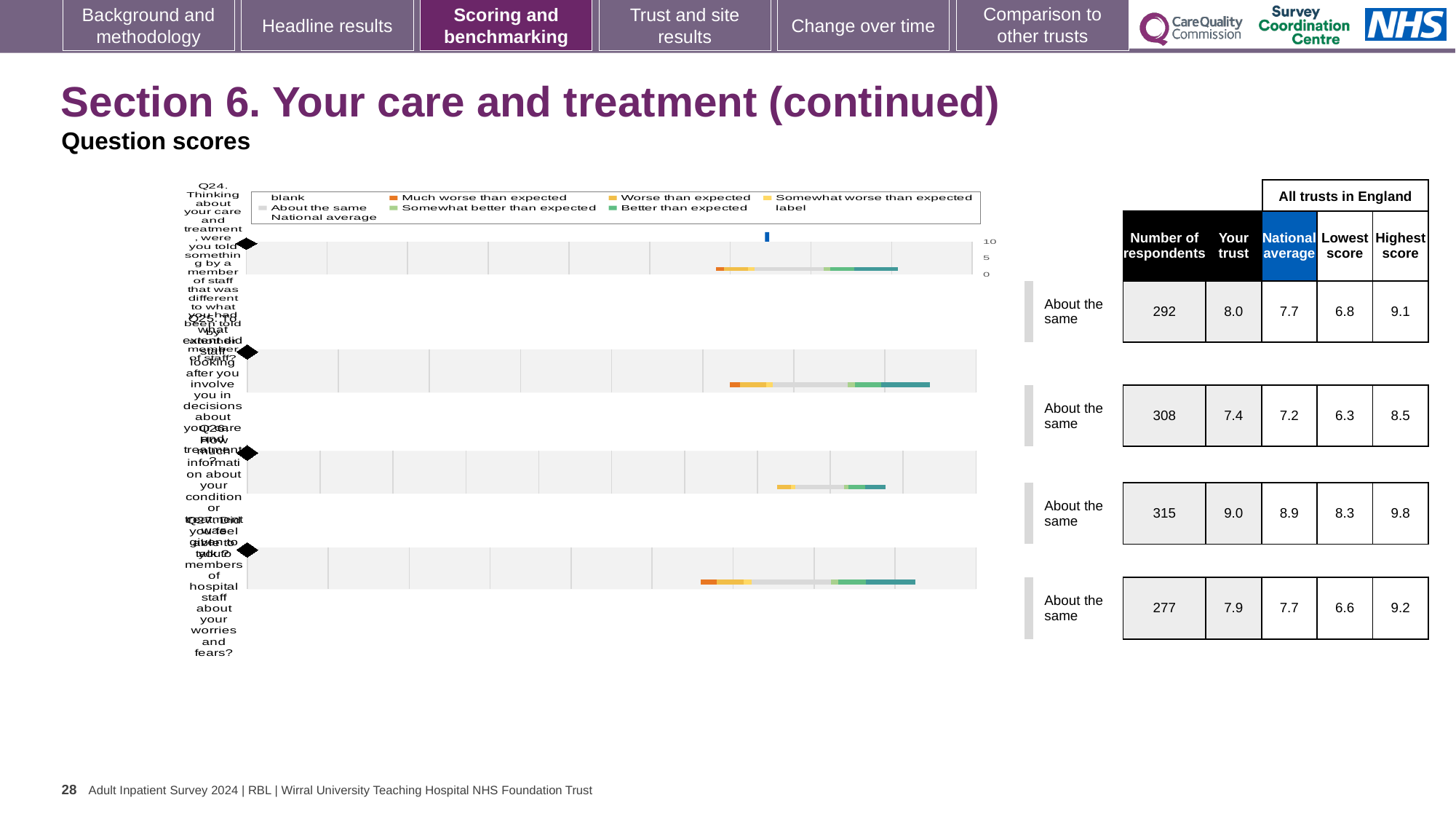
What is the 'Highest score' listed for Q26 (the third row) in the table? 9.8 Which question has the highest 'Your trust' score in the table? Q26 What is the 'Lowest score' listed for Q25 (the second row) in the table? 6.3 Which question has the lowest 'Your trust' score in the table? Q25 For Q24 (the first row), what is the difference between the 'Your trust' score and the 'National average'? 0.3 For Q27 (the last row), which is larger: the 'Your trust' score or the 'National average'? Your trust What kind of chart is used to show the question scores on this slide? bar chart In the table beside the chart, what is the 'Your trust' score for Q24 (the first row)? 8.0 In the table beside the chart, how many respondents are listed for Q26 (the third row)? 315 How many questions (bars) are plotted in the chart? 4 What benchmark category is shown next to each of the four questions? About the same What is the maximum value shown on the chart's score axis? 10